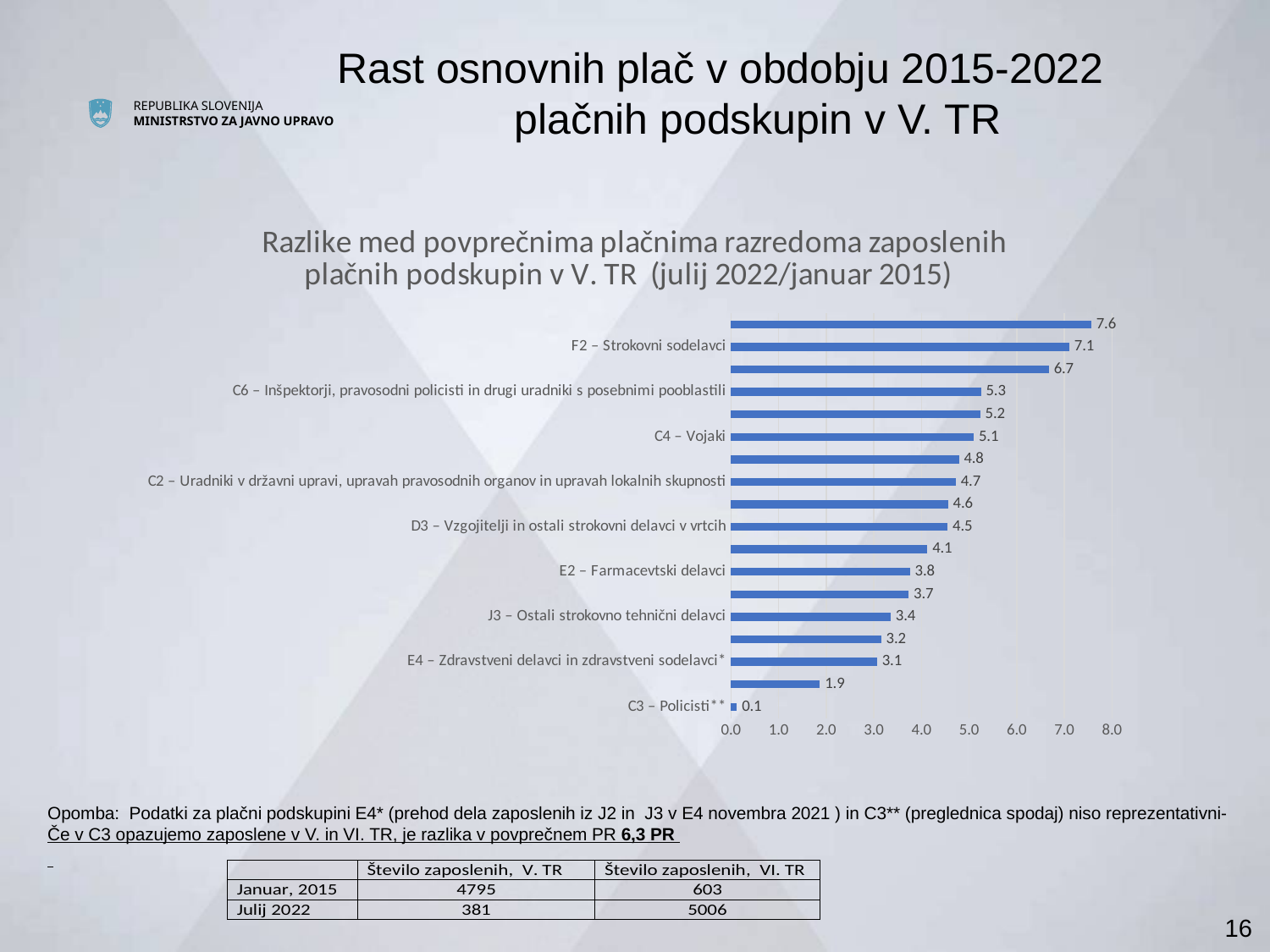
What is the value for J3 – Ostali strokovno tehnični delavci? 3.4 Is the value for C2 – Uradniki v državni upravi, upravah pravosodnih organov in upravah lokalnih skupnosti greater or less than 4.0? greater What is the largest value shown on the chart? 7.6 Which has the larger value: D3 – Vzgojitelji in ostali strokovni delavci v vrtcih or J3 – Ostali strokovno tehnični delavci? D3 – Vzgojitelji in ostali strokovni delavci v vrtcih What is the value for C4 – Vojaki? 5.1 What is the value for C3 – Policisti**? 0.1 What is the value for F2 – Strokovni sodelavci? 7.1 What is the value for E2 – Farmacevtski delavci? 3.8 What kind of chart is shown on the slide? bar chart How many bars are plotted on the chart? 18 What is the difference between the values for F2 – Strokovni sodelavci and C6 – Inšpektorji, pravosodni policisti in drugi uradniki s posebnimi pooblastili? 1.8 Which labelled category has the lowest value? C3 – Policisti**